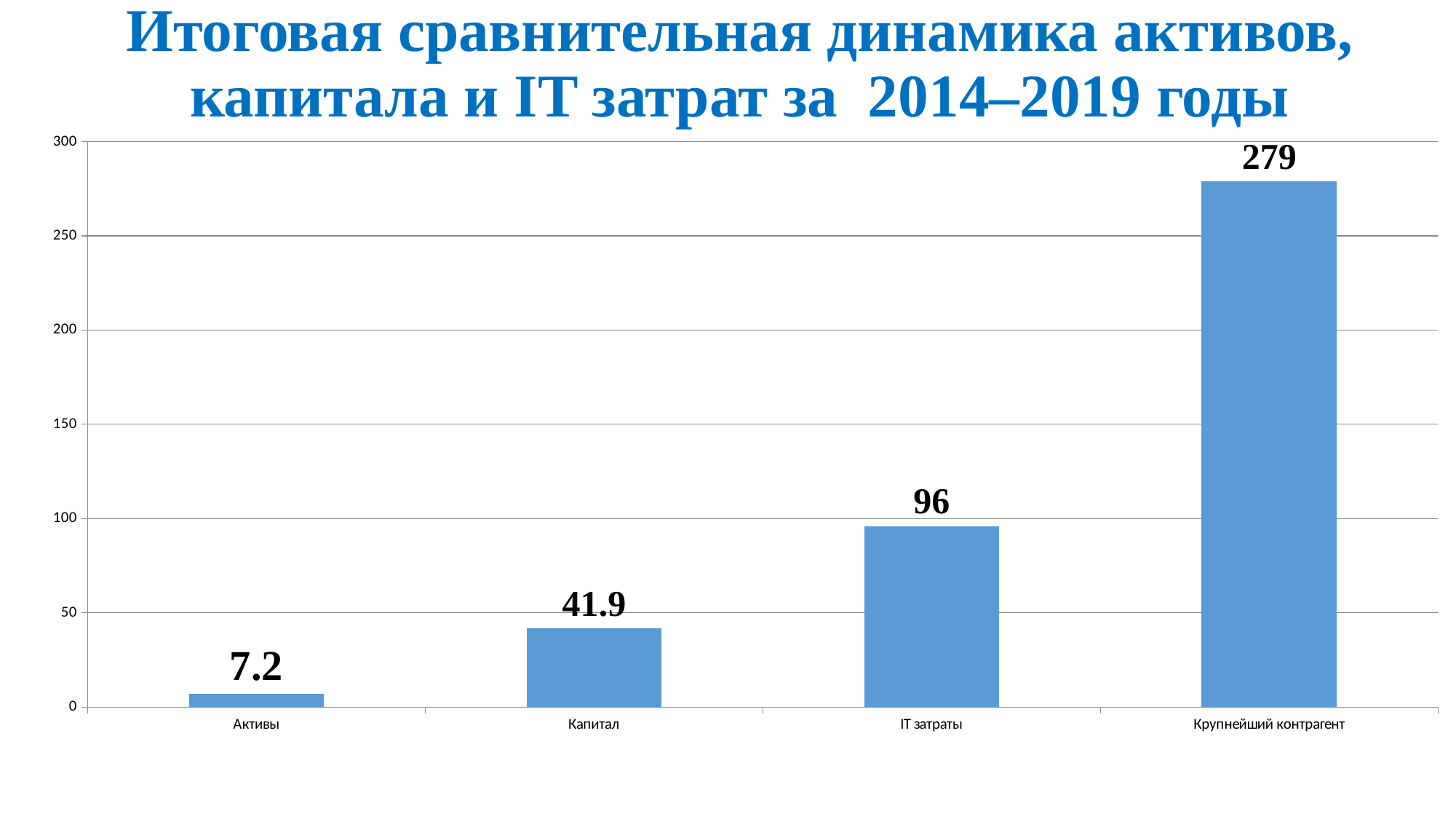
What is the difference between the values for Капитал and Активы? 34.7 Which category has the lowest value? Активы What is the value for Крупнейший контрагент? 279 Which is larger, the value for Капитал or the value for IT затраты? IT затраты How many categories are shown on the chart? 4 What kind of chart is shown on the slide? bar chart What is the value for IT затраты? 96 What is the difference between the values for Крупнейший контрагент and IT затраты? 183 Is the value for IT затраты greater or less than 100? less What is the value for Капитал? 41.9 What is the value for Активы? 7.2 Which category has the highest value? Крупнейший контрагент